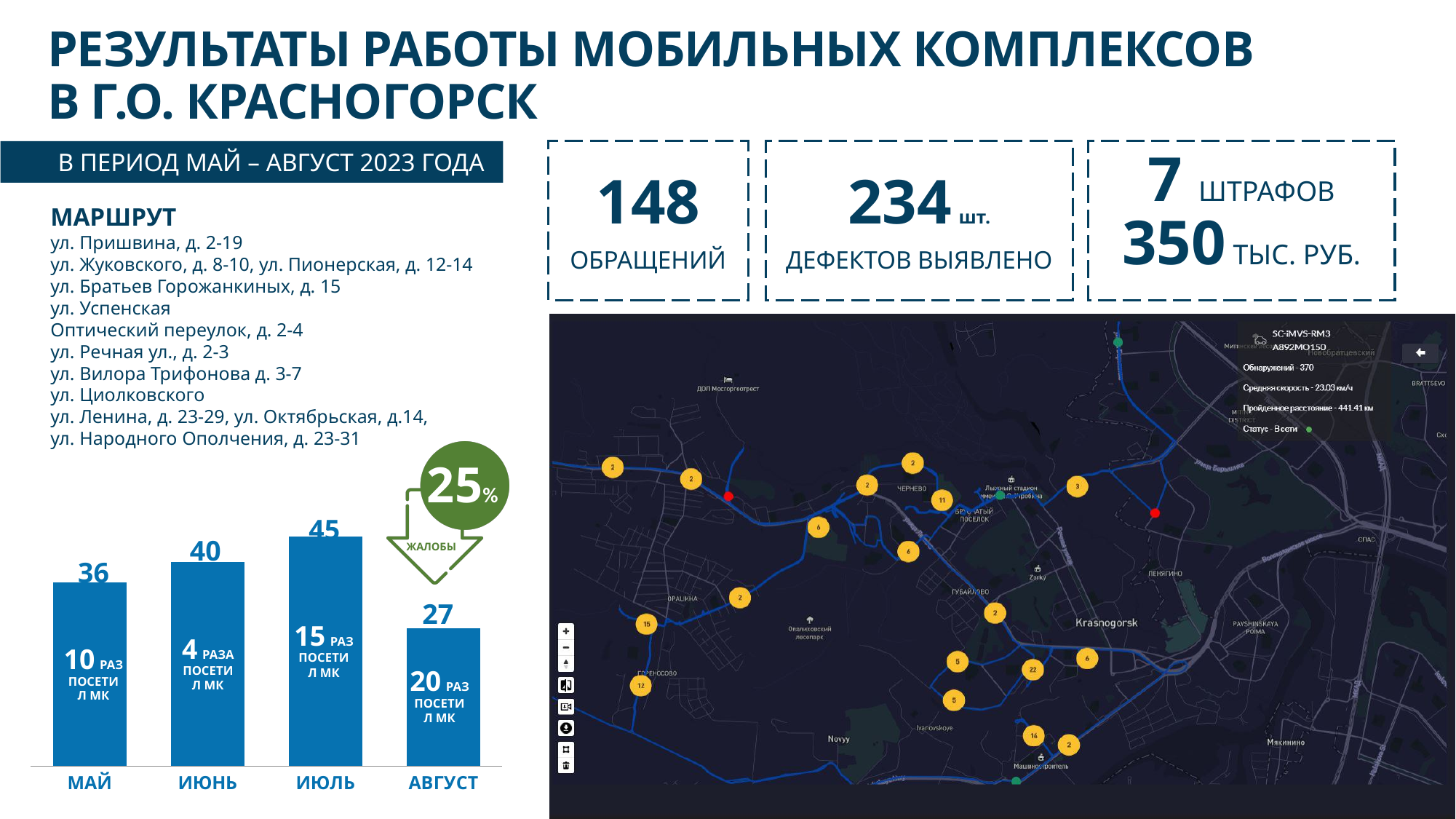
How many months (categories) does the bar chart show? 4 How many times did the mobile complex visit (раз посетил МК) according to the label inside the ИЮЛЬ bar? 15 Which month has the lowest bar in the chart? АВГУСТ What is the value of the bar for МАЙ? 36 Which is larger, the value for МАЙ or the value for ИЮНЬ? ИЮНЬ What is the value of the bar for ИЮНЬ? 40 What percentage is shown in the green arrow labelled ЖАЛОБЫ next to the bar chart? 25% What is the difference between the values for ИЮЛЬ and АВГУСТ? 18 What is the value of the bar for АВГУСТ? 27 Which month has the highest bar in the chart? ИЮЛЬ What is the value of the bar for ИЮЛЬ? 45 What type of chart is shown at the bottom left of the slide? bar chart